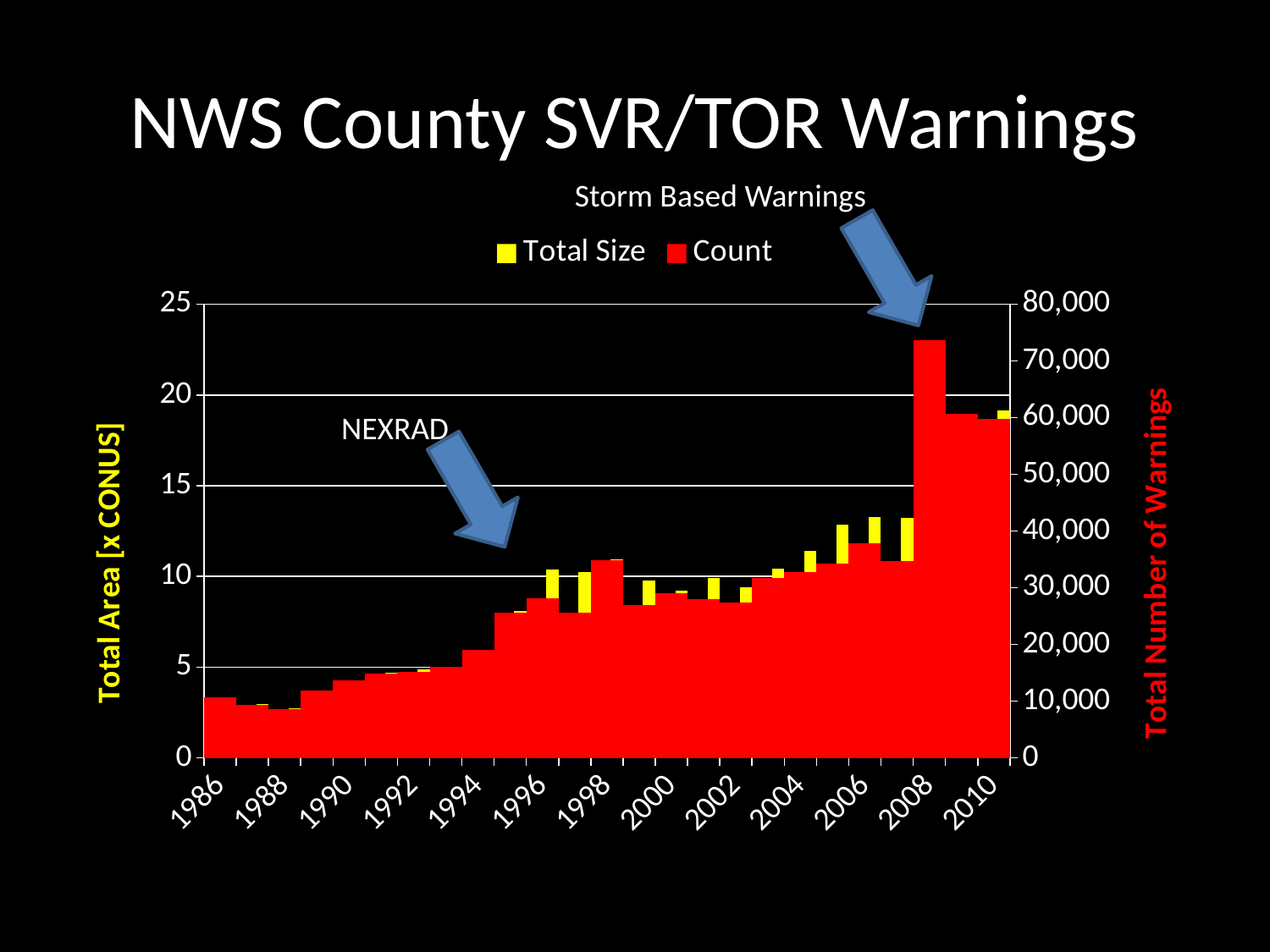
Which series is shown in yellow in the legend? Total Size In which year is the Count highest? 2008 Which year has the larger Count, 1998 or 2008? 2008 What is the title of the right-hand vertical axis? Total Number of Warnings Is the Total Size for 2007 greater or less than 10? greater Is the Count for 1998 greater or less than 30,000? greater Overall, does the Count rise or fall from 1986 to 2010? rise Is the Total Size for 1990 greater or less than 5? less What kind of chart is shown on the slide? bar chart How many series does the legend list? 2